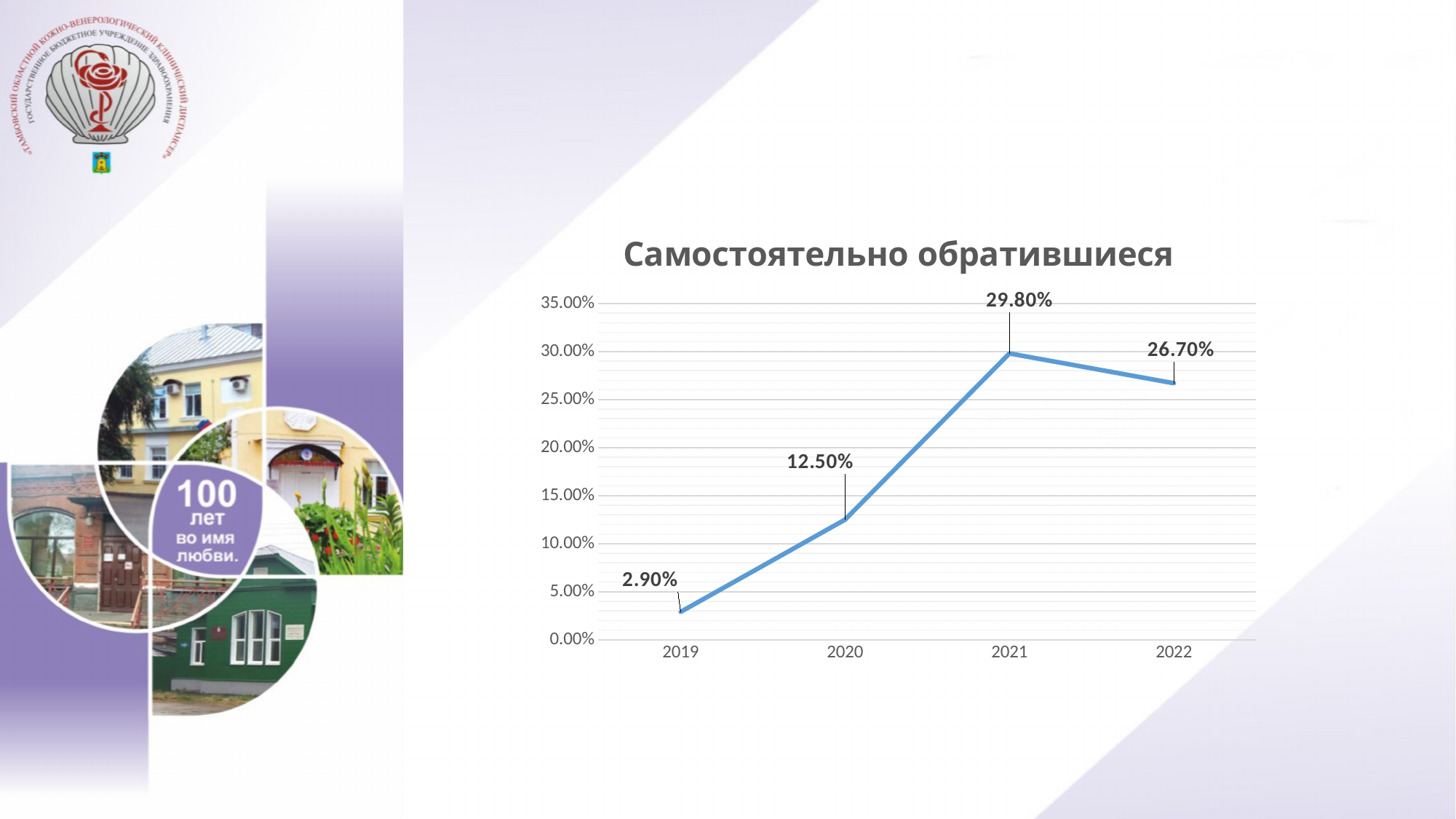
What is the value for 2021? 29.80% What is the value for 2022? 26.70% What is the difference between the values for 2020 and 2019? 9.60% Which year has the lowest value? 2019 What kind of chart is shown? line chart What is the difference between the values for 2021 and 2022? 3.10% What is the value for 2020? 12.50% Which year has the highest value? 2021 How many years are plotted on the chart? 4 Which is larger, the value for 2020 or the value for 2022? 2022 What is the title of the chart? Самостоятельно обратившиеся What is the value for 2019? 2.90%